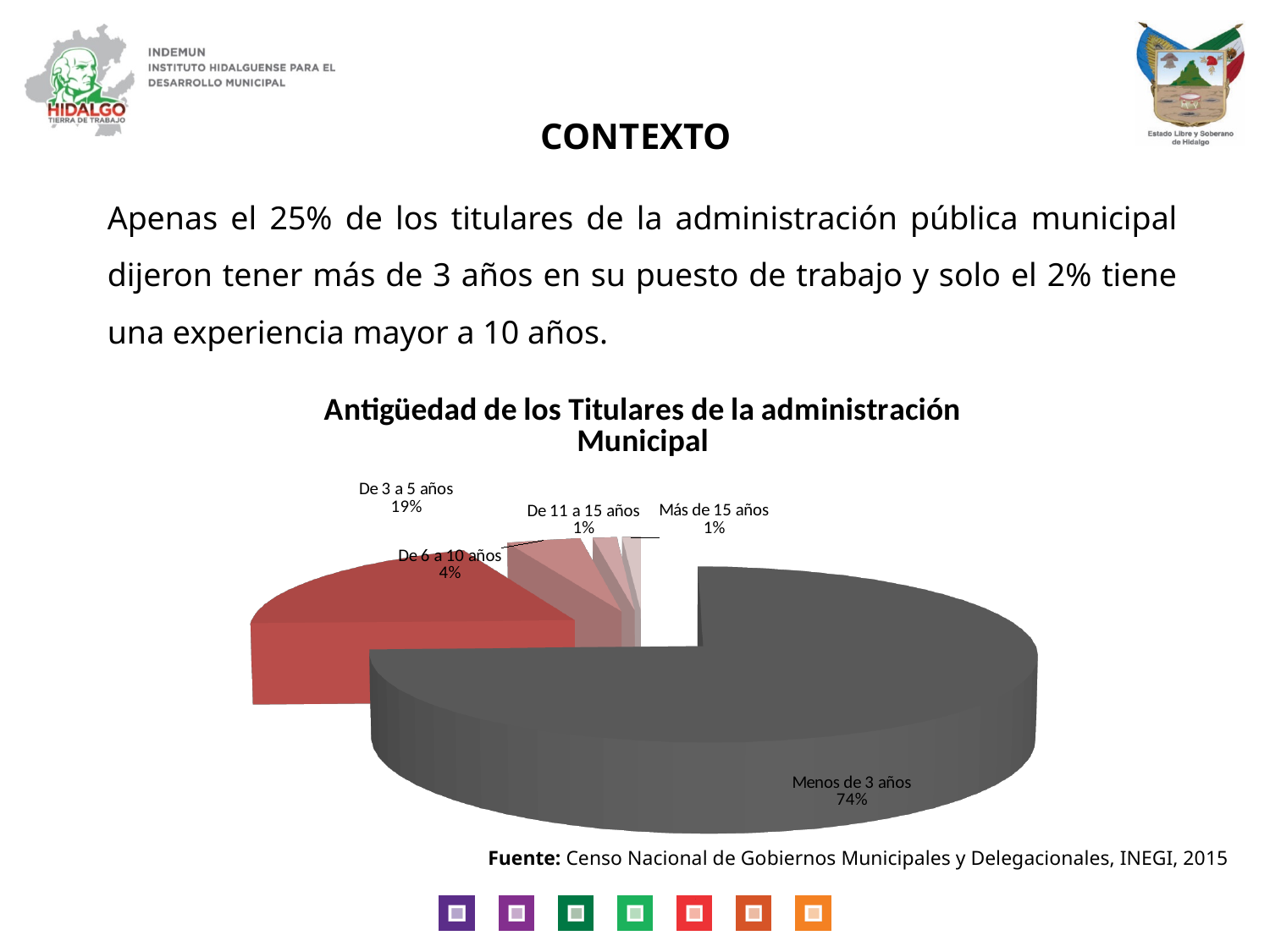
What is the difference between the shares of "Menos de 3 años" and "De 3 a 5 años"? 55% What is the source cited below the chart? Censo Nacional de Gobiernos Municipales y Delegacionales, INEGI, 2015 Which category has the largest share of the pie? Menos de 3 años How many categories are shown in the pie chart? 5 What share of the pie does "Menos de 3 años" represent? 74% What kind of chart is shown on the slide? Pie chart What is the value for "De 6 a 10 años"? 4% What is the value for "De 11 a 15 años"? 1% What is the title of the chart? Antigüedad de los Titulares de la administración Municipal What is the value for "Más de 15 años"? 1% What is the value for "De 3 a 5 años"? 19% Which is larger, the share for "De 3 a 5 años" or the share for "De 6 a 10 años"? De 3 a 5 años